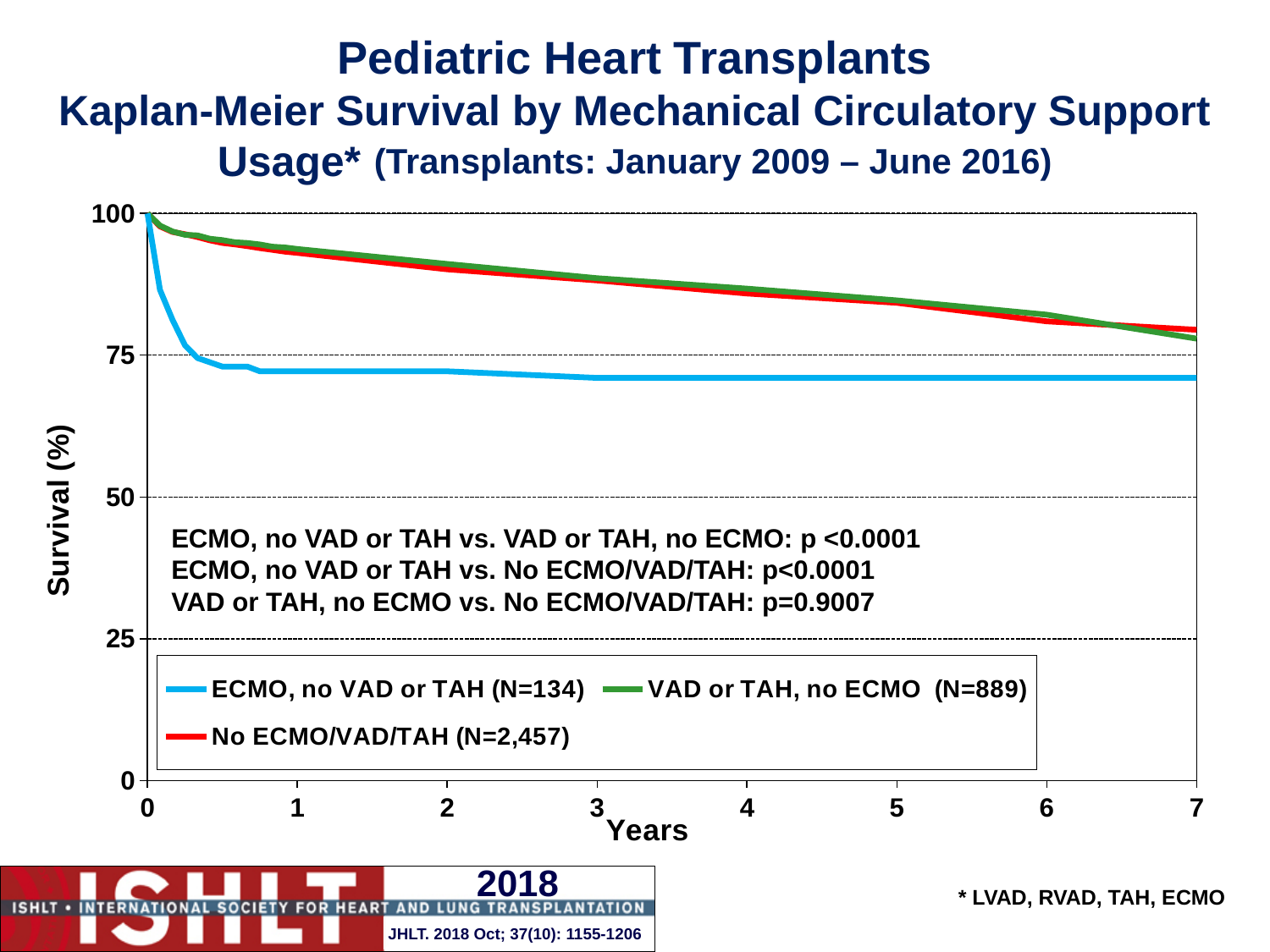
What is the N for the No ECMO/VAD/TAH group shown in the legend? N=2,457 What kind of chart is shown on the slide? line chart Is the survival value for the ECMO, no VAD or TAH group at 7 years greater or less than 75? less Is the survival value for the ECMO, no VAD or TAH group at 1 year greater or less than 50? greater Is the survival value for the VAD or TAH, no ECMO group at 7 years greater or less than 75? greater Which group has the lowest survival at 7 years? ECMO, no VAD or TAH How many series does the legend list? 3 Does survival for the ECMO, no VAD or TAH group rise or fall as years increase? fall Does survival for the VAD or TAH, no ECMO group rise or fall over the 7 years? fall What is the p-value shown for VAD or TAH, no ECMO vs. No ECMO/VAD/TAH? p=0.9007 At 3 years, which group has higher survival: ECMO, no VAD or TAH, or VAD or TAH, no ECMO? VAD or TAH, no ECMO